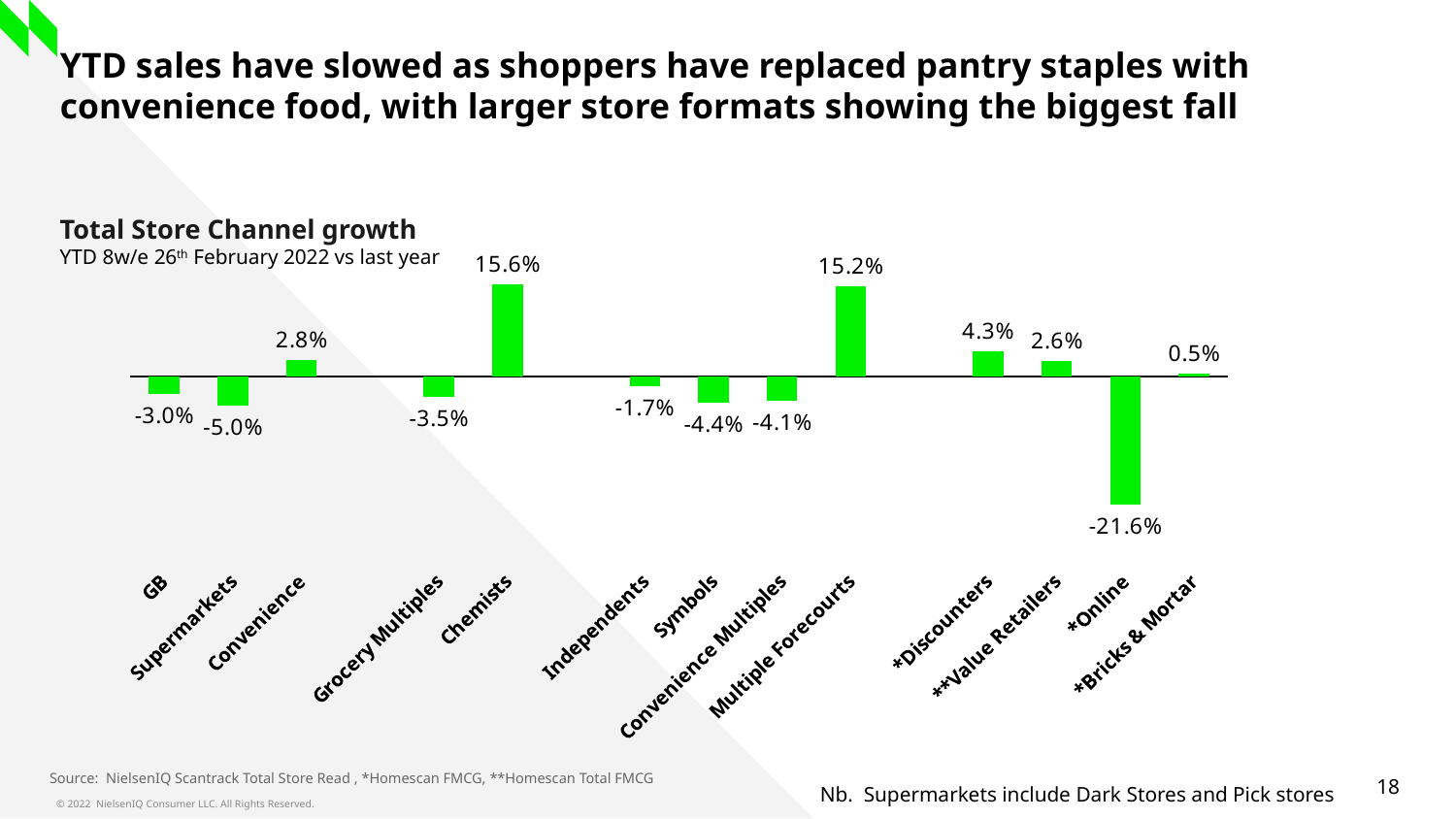
What is the growth value for Multiple Forecourts? 15.2% How many channels are shown in the chart? 13 What type of chart is shown on the slide? Bar chart Which channel has the highest growth value? Chemists Which has a higher growth value, *Discounters or **Value Retailers? *Discounters What is the title of the chart? Total Store Channel growth What is the growth value for Chemists? 15.6% What is the growth value for Supermarkets? -5.0% What is the growth value for *Online? -21.6% What is the difference between the growth values for Chemists and Multiple Forecourts? 0.4% What is the difference between the growth values for GB and Supermarkets? 2.0% Which channel has the lowest growth value? *Online